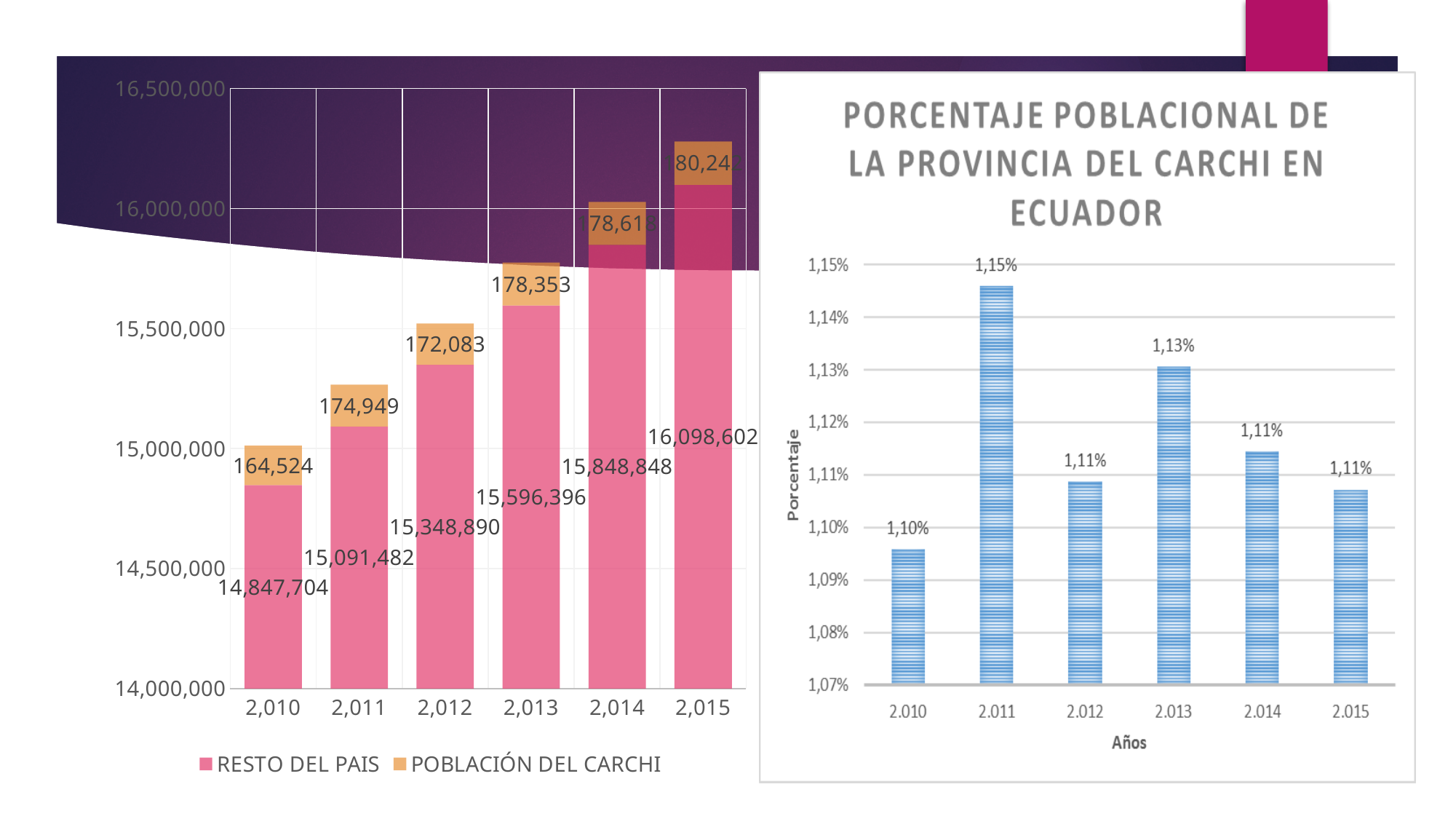
In the stacked bar chart on the left, what is the value for RESTO DEL PAIS in 2,015? 16,098,602 In the stacked bar chart on the left, what is the difference between the RESTO DEL PAIS values for 2,011 and 2,010? 243,778 In the stacked bar chart on the left, what is the total of the stacked bar for 2,012? 15,520,973 In the stacked bar chart on the left, does the RESTO DEL PAIS value rise or fall from 2,010 to 2,015? rise In the stacked bar chart on the left, how many series does the legend list? 2 In the chart titled PORCENTAJE POBLACIONAL DE LA PROVINCIA DEL CARCHI EN ECUADOR, what is the value for 2.013? 1,13% In the chart titled PORCENTAJE POBLACIONAL DE LA PROVINCIA DEL CARCHI EN ECUADOR, which year has the highest value? 2.011 In the stacked bar chart on the left, what is the value for RESTO DEL PAIS in 2,013? 15,596,396 In the chart titled PORCENTAJE POBLACIONAL DE LA PROVINCIA DEL CARCHI EN ECUADOR, how many years are shown on the x axis? 6 What kind of chart is the one titled PORCENTAJE POBLACIONAL DE LA PROVINCIA DEL CARCHI EN ECUADOR? bar chart In the stacked bar chart on the left, what is the value for POBLACIÓN DEL CARCHI in 2,011? 174,949 In the chart titled PORCENTAJE POBLACIONAL DE LA PROVINCIA DEL CARCHI EN ECUADOR, which year has the lowest value? 2.010